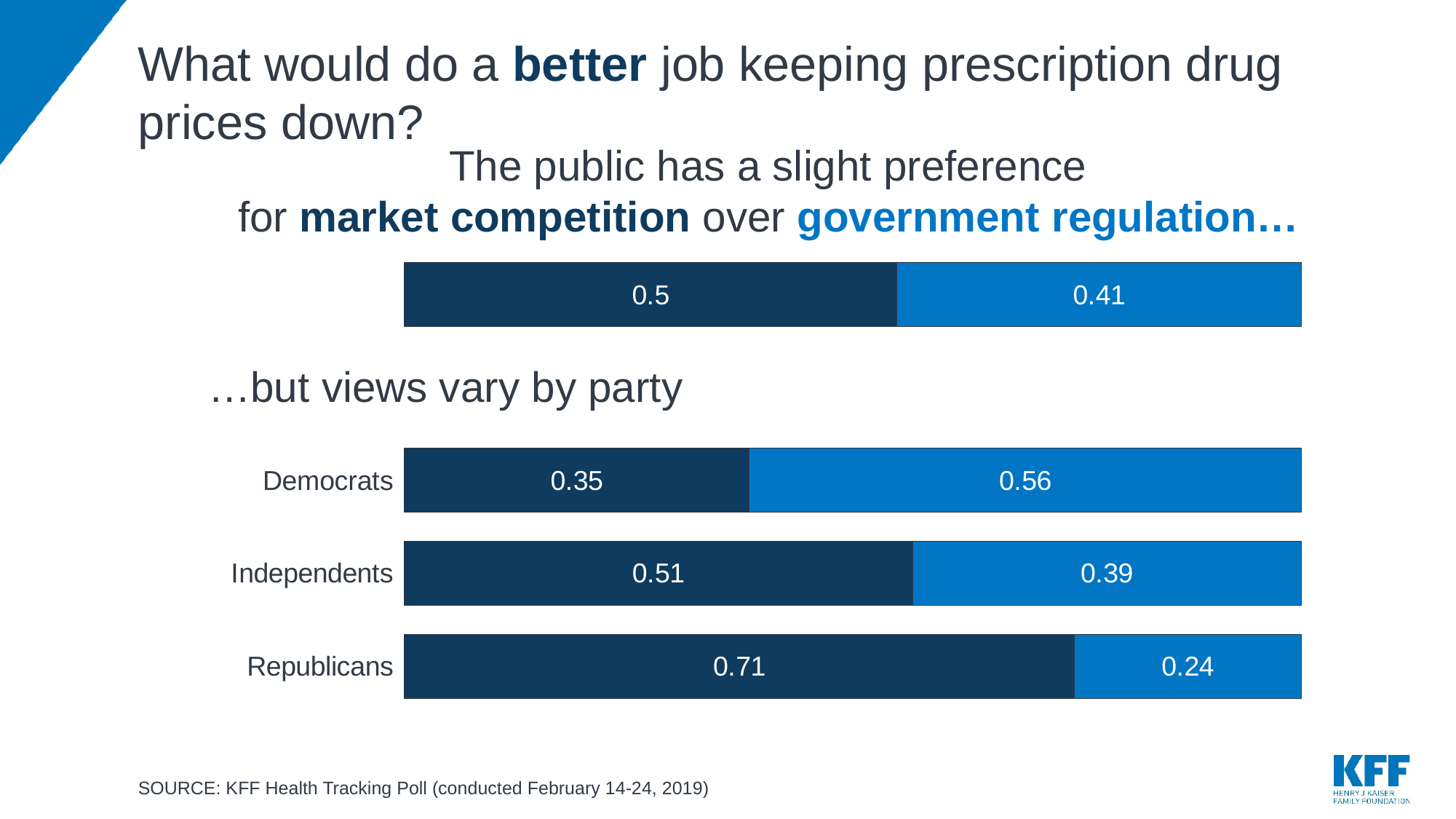
In the bottom chart (views by party), which is larger for Independents: the dark blue (market competition) value or the light blue (government regulation) value? Dark blue (market competition), 0.51 What kind of chart is used in the bottom chart (views by party)? Stacked horizontal bar chart In the bottom chart (views by party), which party has the highest dark blue (market competition) value? Republicans In the bottom chart (views by party), what is the light blue (government regulation) value for Democrats? 0.56 In the bottom chart (views by party), what is the difference between the Democrats' light blue (government regulation) value and the Independents' light blue value? 0.17 In the top chart (the public overall), what is the value of the light blue (government regulation) segment? 0.41 In the top chart (the public overall), what is the value of the dark blue (market competition) segment? 0.5 In the bottom chart (views by party), which party has the lowest light blue (government regulation) value? Republicans In the bottom chart (views by party), what is the total of the two segments for Democrats? 0.91 In the bottom chart (views by party), what is the dark blue (market competition) value for Republicans? 0.71 How many party categories are shown in the bottom chart? 3 In the bottom chart (views by party), what is the difference between the Republicans' and Democrats' dark blue (market competition) values? 0.36